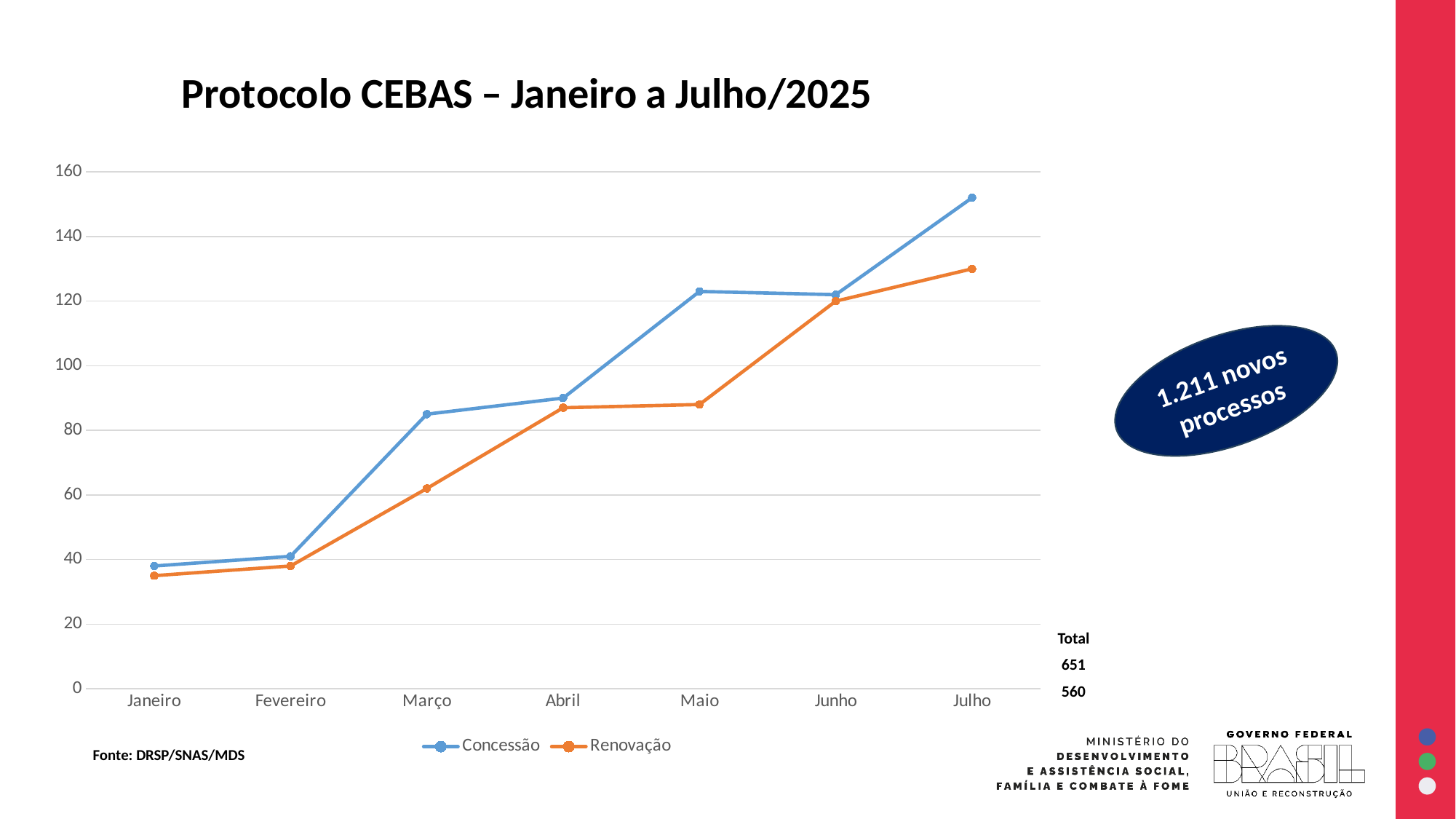
What is the title of the chart? Protocolo CEBAS – Janeiro a Julho/2025 How many months are plotted along the x axis? 7 Is the value for Renovação in Março greater or less than 80? less What kind of chart is shown on the slide? Line chart In which month is the Renovação series at its lowest value? Janeiro Is the value for Renovação in Julho greater or less than 140? less Does the Renovação series generally rise or fall from Janeiro to Julho? Rise In which month does the Concessão series reach its highest value? Julho How many series does the legend list? 2 Is the value for Concessão in Julho greater or less than 140? greater In Maio, which series has the larger value, Concessão or Renovação? Concessão